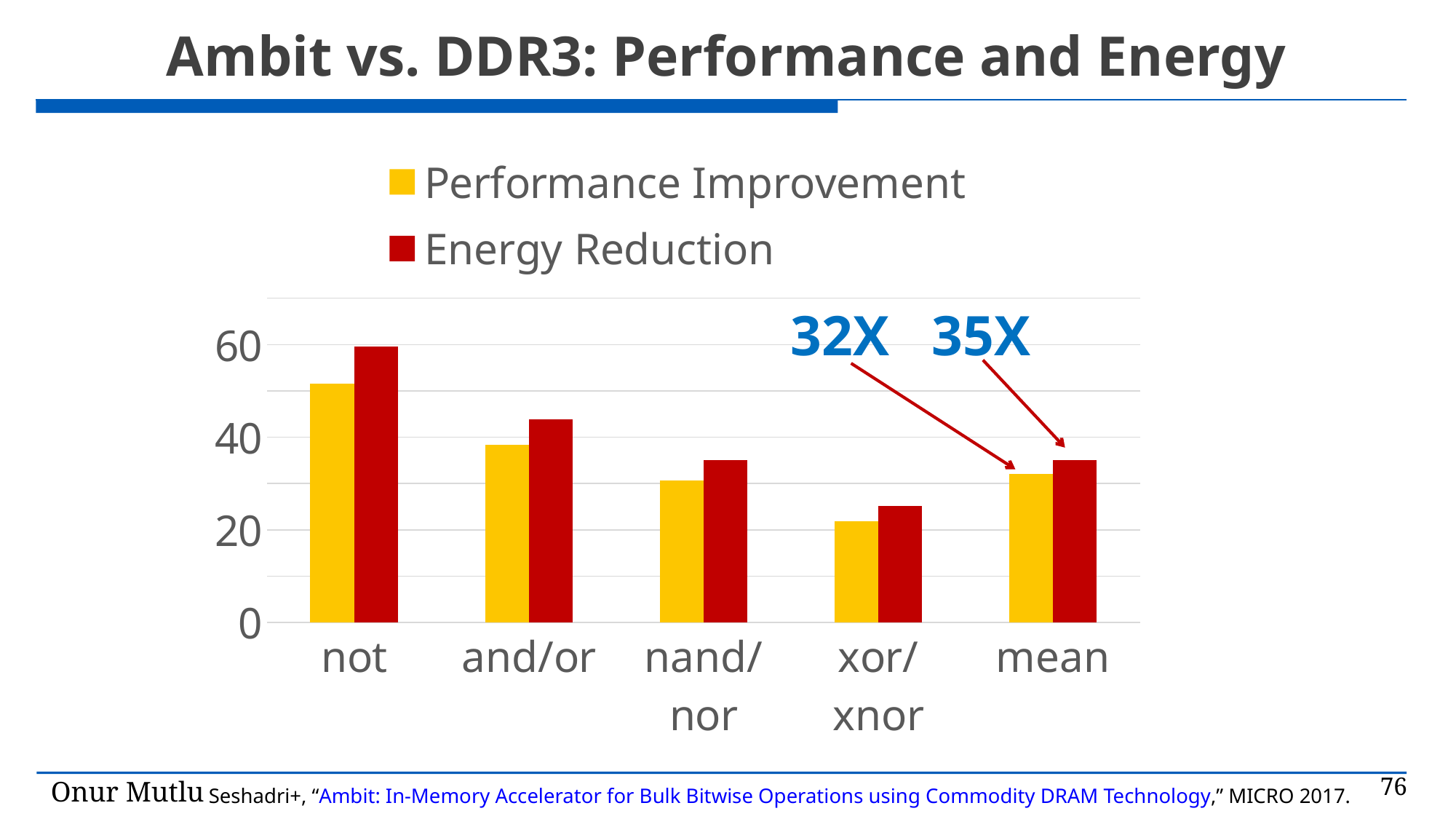
What is the mean Performance Improvement annotated on the chart? 32X Is the Performance Improvement for xor/xnor greater or less than 40? less Which operation has the highest Performance Improvement? not Which operation has the lowest Energy Reduction? xor/xnor How many series does the legend list? 2 Do the Performance Improvement values rise or fall going from not to xor/xnor along the x axis? fall How many categories are shown along the x axis? 5 Is the Energy Reduction for not greater or less than 40? greater Which has the larger Energy Reduction, not or and/or? not What is the difference between the annotated mean Energy Reduction and the annotated mean Performance Improvement? 3X What kind of chart is shown on the slide? bar chart What is the mean Energy Reduction annotated on the chart? 35X